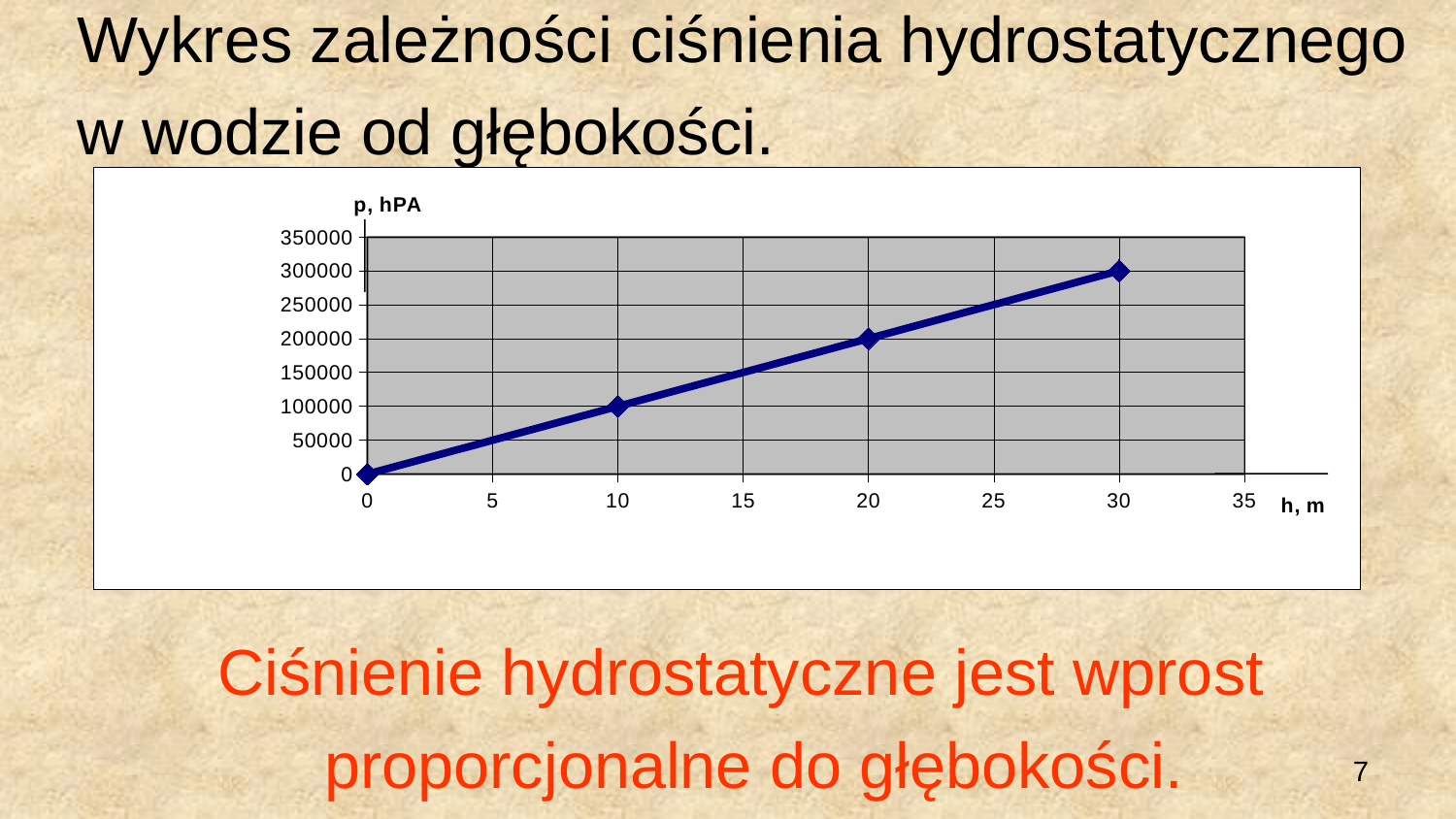
At which depth h is the plotted pressure highest? 30 What kind of chart is shown on the slide? line chart At which depth h is the plotted pressure lowest? 0 What is the value of p at h = 30 m? 300000 What is the value of p at h = 10 m? 100000 How many data points are plotted on the chart? 4 Which is larger, the pressure at h = 20 m or at h = 10 m? h = 20 m What is the value of p at h = 20 m? 200000 What is the difference between the pressure at h = 30 m and at h = 10 m? 200000 Does the pressure rise or fall as depth h increases along the x axis? rise What label is shown on the vertical axis of the chart? p, hPA What is the value of p at h = 0 m? 0